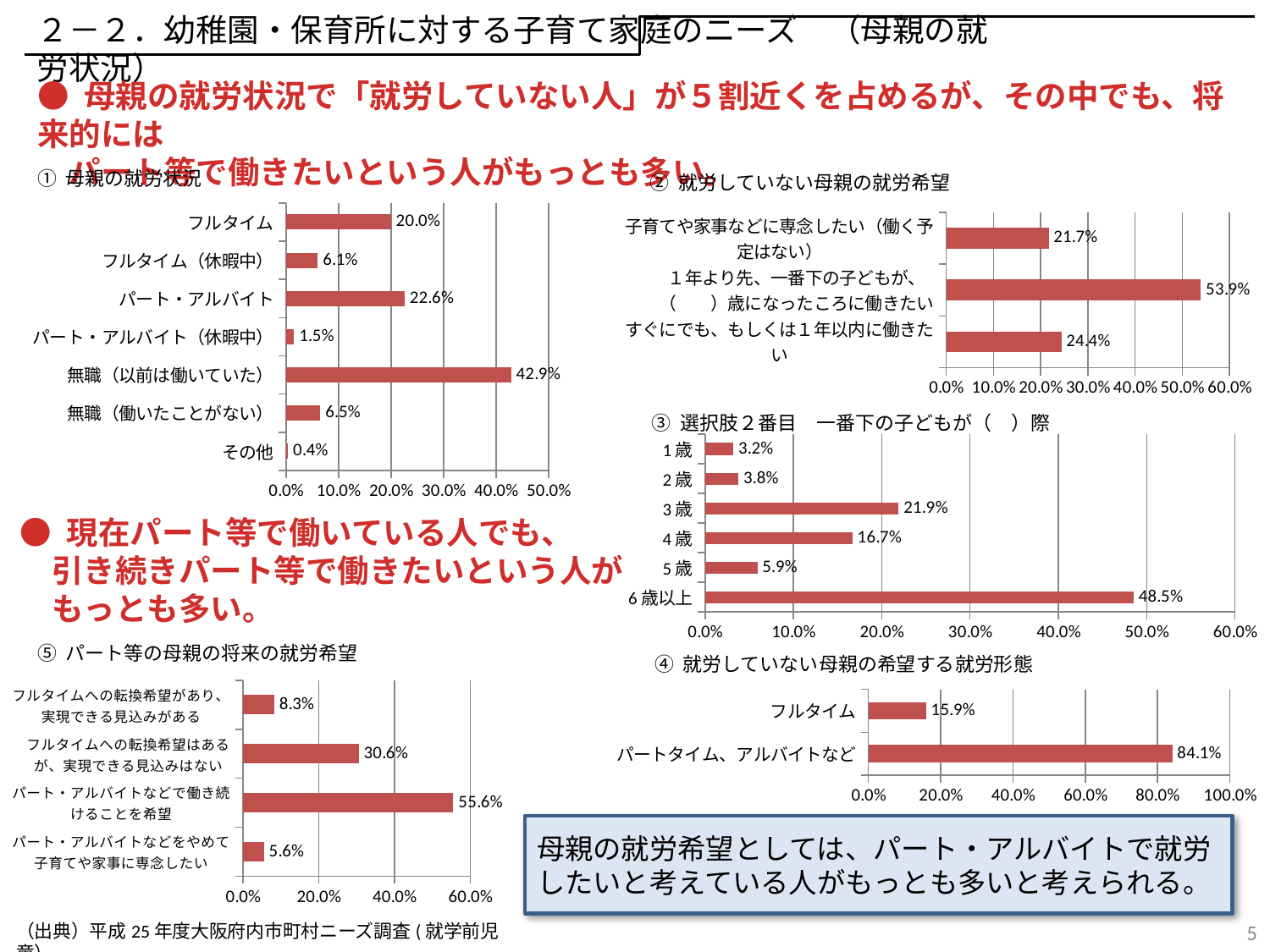
In the chart ⑤ パート等の母親の将来の就労希望, what is the value for パート・アルバイトなどで働き続けることを希望? 55.6% In the chart ① 母親の就労状況, what is the value for 無職（以前は働いていた）? 42.9% In the chart ② 就労していない母親の就労希望, which category has the highest value? １年より先、一番下の子どもが、（ ）歳になったころに働きたい In the chart ① 母親の就労状況, what is the difference between パート・アルバイト and フルタイム? 2.6% In the chart ① 母親の就労状況, how many categories are plotted? 7 In the chart ③ 選択肢２番目 一番下の子どもが（ ）際, which is larger, 4歳 or 5歳? 4歳 In the chart ① 母親の就労状況, which category has the lowest value? その他 In the chart ④ 就労していない母親の希望する就労形態, what is the value for パートタイム、アルバイトなど? 84.1% In the chart ② 就労していない母親の就労希望, what is the value for すぐにでも、もしくは１年以内に働きたい? 24.4% In the chart ③ 選択肢２番目 一番下の子どもが（ ）際, how many categories are plotted? 6 In the chart ③ 選択肢２番目 一番下の子どもが（ ）際, what is the value for 3歳? 21.9% What type of chart is ⑤ パート等の母親の将来の就労希望? Bar chart